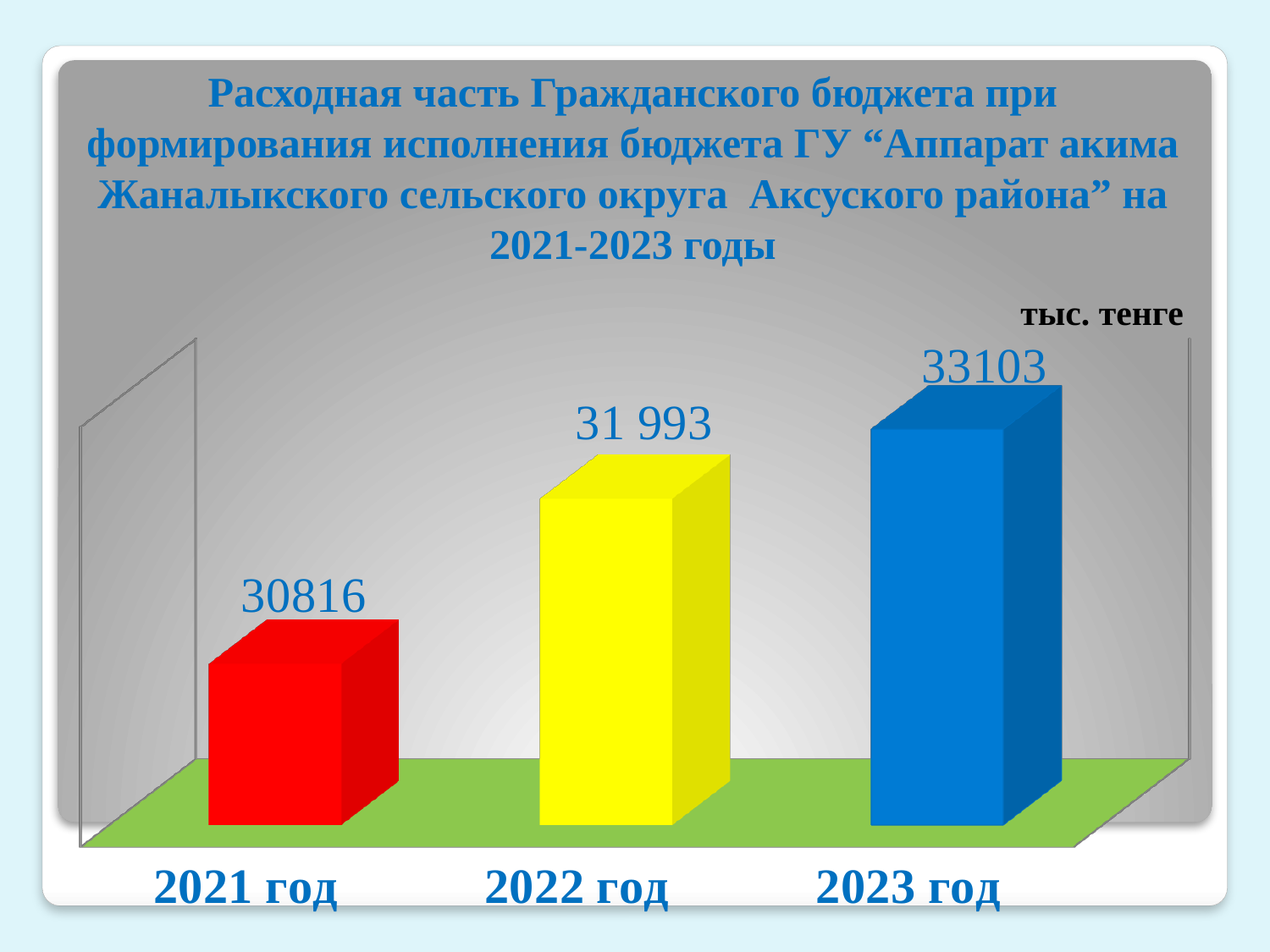
What is the value shown for 2021 год? 30816 What is the difference between the values for 2023 год and 2021 год? 2287 What unit of measurement is indicated for the chart values? тыс. тенге Which year has the highest value? 2023 год What kind of chart is shown on the slide? bar chart How many years (categories) are shown in the chart? 3 Do the values rise or fall from 2021 год to 2023 год? rise What is the value shown for 2022 год? 31 993 Which year has the lowest value? 2021 год What is the value shown for 2023 год? 33103 What is the difference between the values for 2022 год and 2021 год? 1177 Which is larger, the value for 2022 год or the value for 2023 год? 2023 год